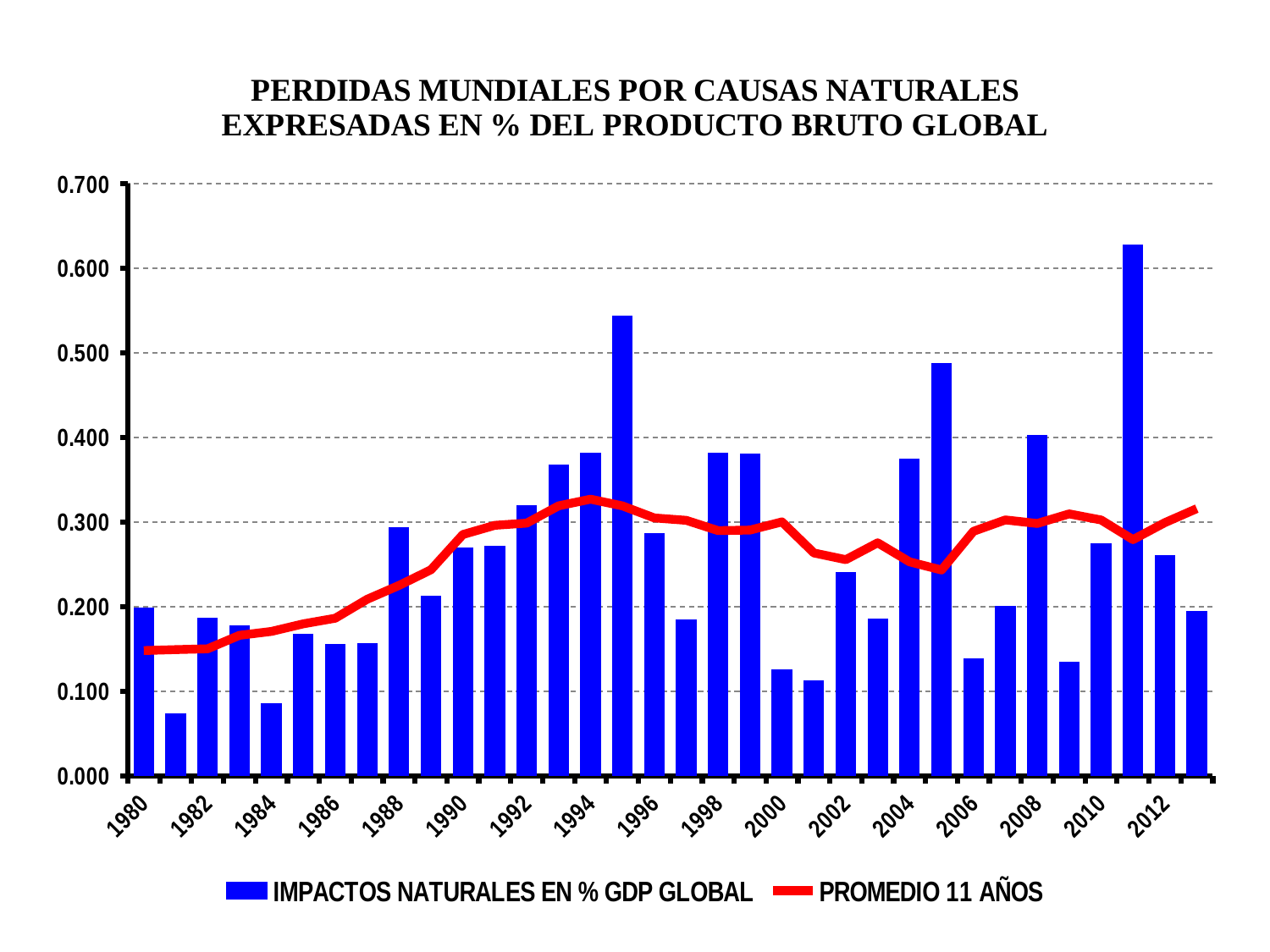
Is the bar value for 1995 greater or less than 0.500? greater Which year has the larger bar, 1995 or 2005? 1995 Which year has the highest bar for IMPACTOS NATURALES EN % GDP GLOBAL? 2011 Does the PROMEDIO 11 AÑOS line rise or fall from 1980 to 1994? rise What kind of chart is shown on the slide? Bar chart with a line Is the bar value for 1984 greater or less than 0.100? less Is the bar value for 2011 greater or less than 0.600? greater How many yearly bars are plotted in the chart? 34 What is the name of the series drawn as a red line? PROMEDIO 11 AÑOS How many series does the legend list? 2 Which year has the lowest bar for IMPACTOS NATURALES EN % GDP GLOBAL? 1981